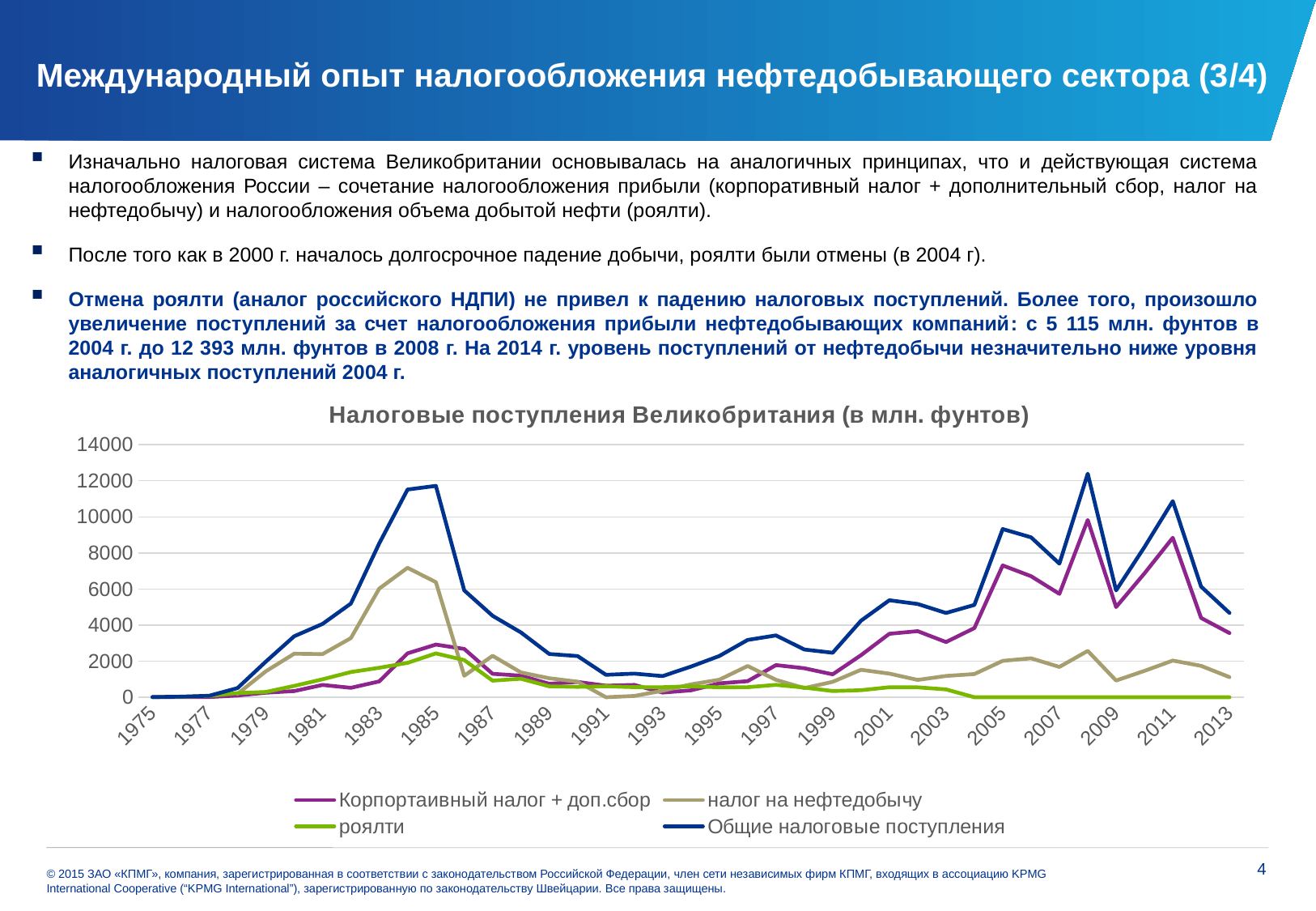
Is the value of роялти in 2005 greater or less than 2000? less What is the highest value shown on the vertical axis? 14000 Is the value of Общие налоговые поступления in 1985 greater or less than 10000? greater How many series does the chart legend list? 4 In 1984, which is larger: налог на нефтедобычу or Корпортаивный налог + доп.сбор? налог на нефтедобычу In 2008, which is larger: Общие налоговые поступления or роялти? Общие налоговые поступления Is the value of Корпортаивный налог + доп.сбор in 2008 greater or less than 8000? greater What is the title of the chart? Налоговые поступления Великобритания (в млн. фунтов) Which series reaches the highest value on the chart? Общие налоговые поступления Do the values of Общие налоговые поступления rise or fall between 1985 and 1991? fall What kind of chart is shown on the slide? line chart